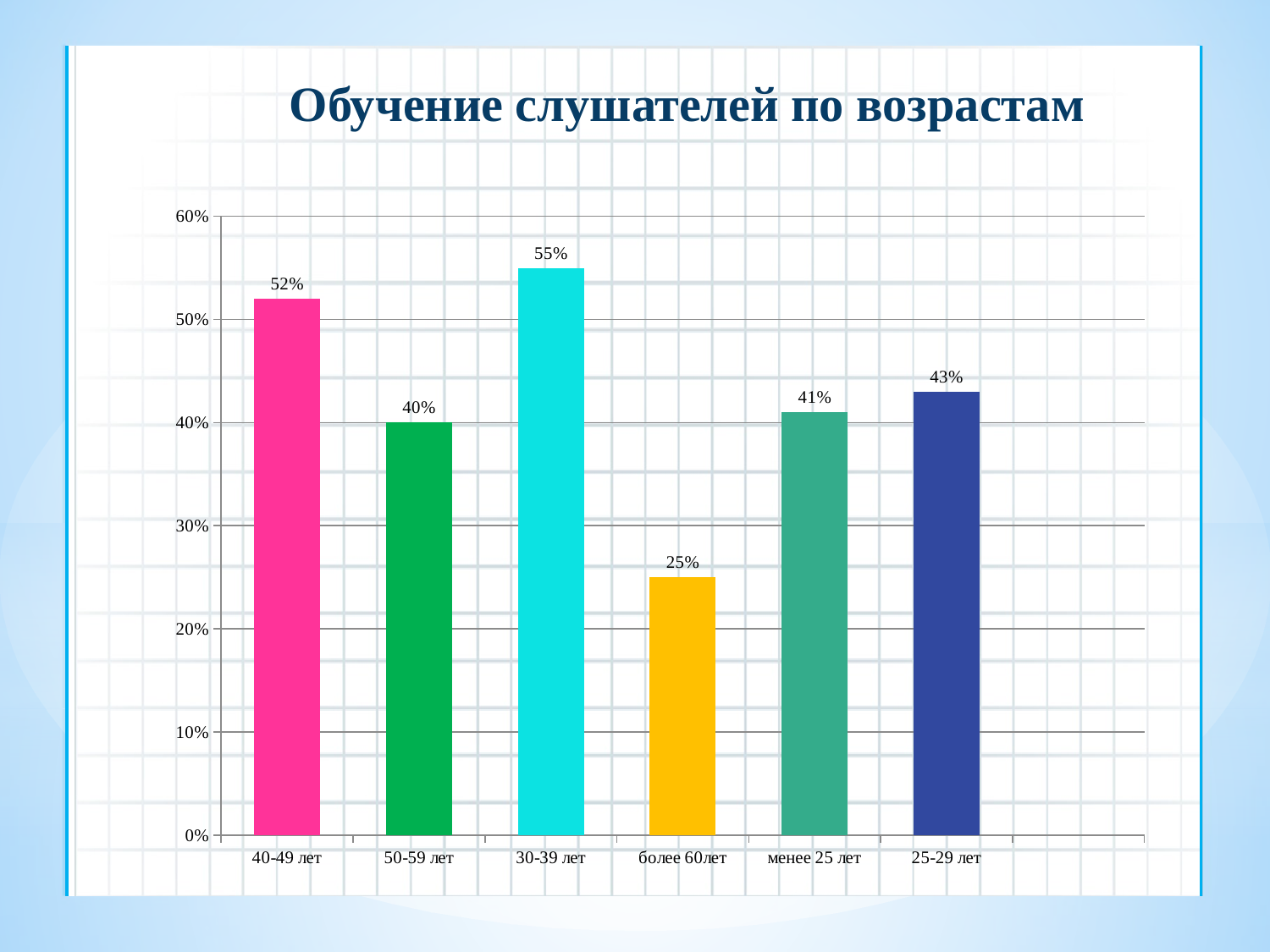
Which category has the highest value? 30-39 лет Which is larger, the value for 25-29 лет or the value for 50-59 лет? 25-29 лет What is the value for менее 25 лет? 41% What kind of chart is shown on the slide? bar chart Which category has the lowest value? более 60лет What is the title of the chart? Обучение слушателей по возрастам What colour is the bar for более 60лет? yellow What is the value for более 60лет? 25% What is the value for 40-49 лет? 52% What is the difference between the values for 30-39 лет and 50-59 лет? 15% Is the value for 40-49 лет greater or less than 50%? greater How many categories are shown on the chart? 6